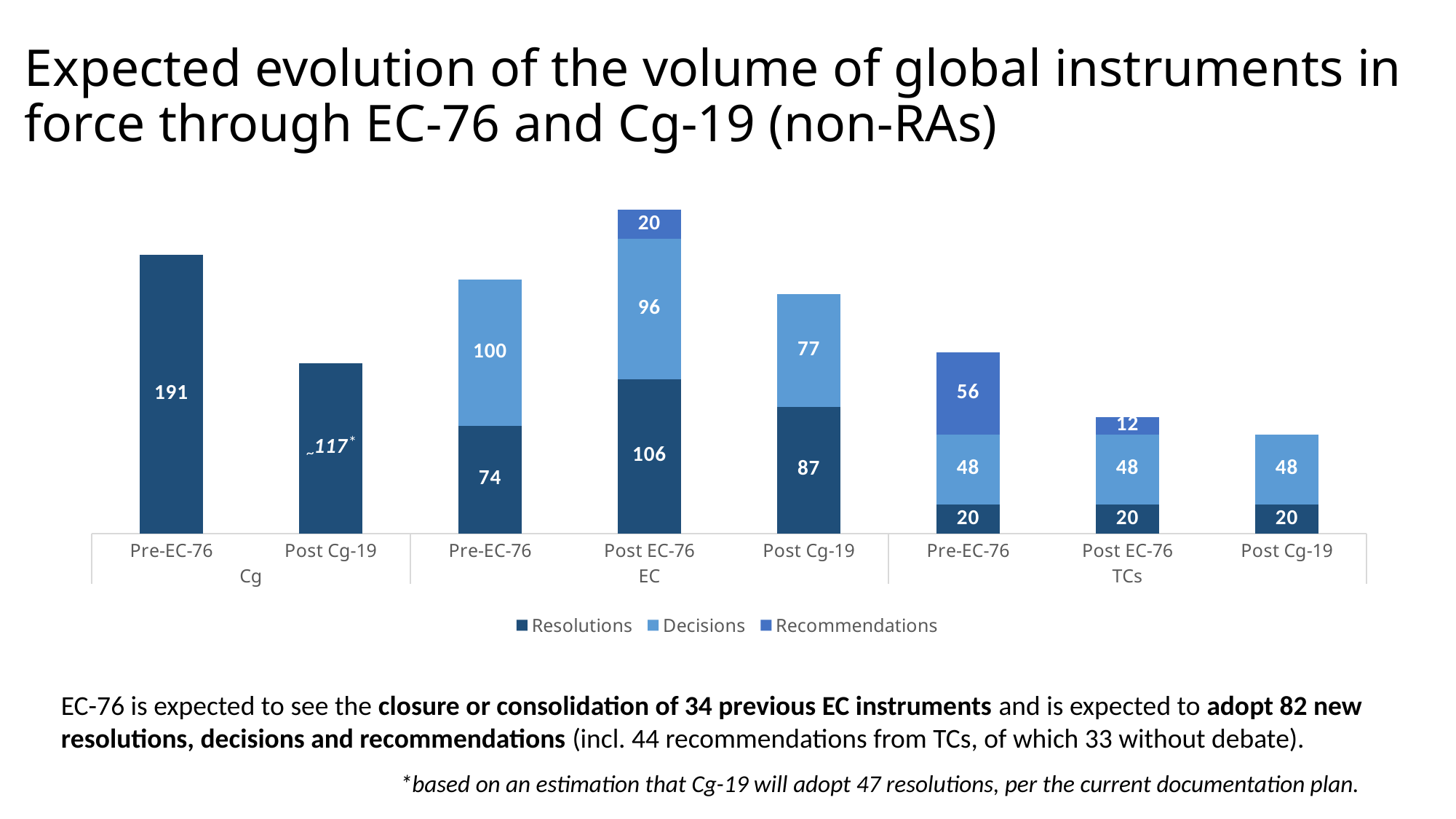
What is the Recommendations value for Pre-EC-76 in the TCs group? 56 What is the total of the stacked bar for Post EC-76 in the EC group? 222 What is the total of the stacked bar for Pre-EC-76 in the TCs group? 124 Which is larger: the Recommendations value for Pre-EC-76 in the TCs group or for Post EC-76 in the TCs group? Pre-EC-76 (TCs) What is the Resolutions value for Pre-EC-76 in the Cg group? 191 What is the Resolutions value for Post Cg-19 in the EC group? 87 What is the Decisions value for Post EC-76 in the EC group? 96 Which bar has the highest Resolutions value? Pre-EC-76 (Cg) How many bars are plotted in the chart? 8 How many series does the legend list? 3 What is the difference between the Decisions values for Pre-EC-76 and Post Cg-19 in the EC group? 23 What kind of chart is shown on the slide? Stacked bar chart